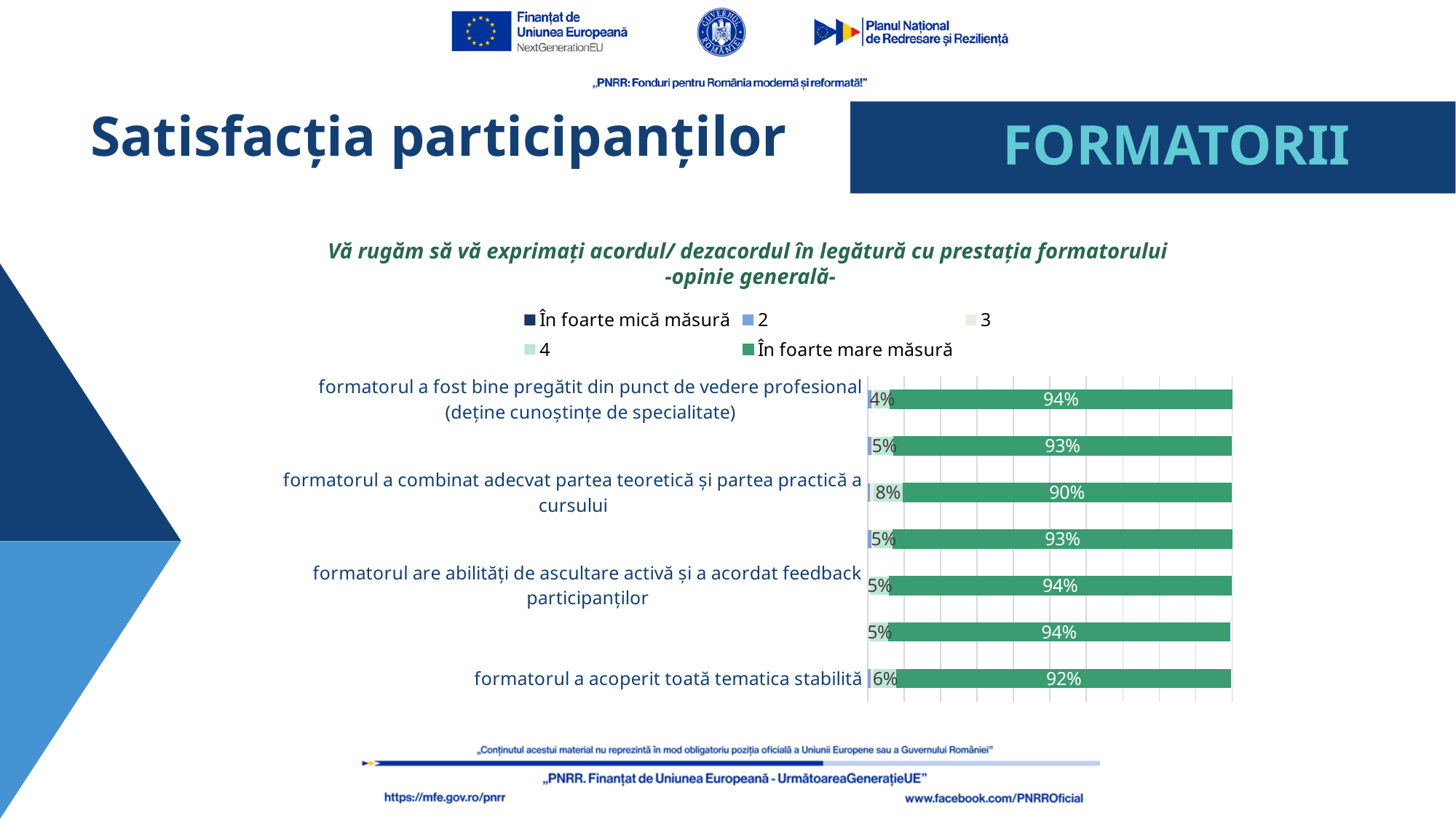
What kind of chart is shown on the slide? bar chart What is the "În foarte mare măsură" value for "formatorul a acoperit toată tematica stabilită"? 92% Which has the larger "În foarte mare măsură" value: "formatorul a acoperit toată tematica stabilită" or "formatorul a combinat adecvat partea teoretică și partea practică a cursului"? formatorul a acoperit toată tematica stabilită What is the difference between the "În foarte mare măsură" values for "formatorul a fost bine pregătit din punct de vedere profesional" and "formatorul a combinat adecvat partea teoretică și partea practică a cursului"? 4 percentage points Which labelled category has the lowest "În foarte mare măsură" value? formatorul a combinat adecvat partea teoretică și partea practică a cursului What is the "4" value for "formatorul a combinat adecvat partea teoretică și partea practică a cursului"? 8% How many series does the chart legend list? 5 What is the "În foarte mare măsură" value for "formatorul are abilități de ascultare activă și a acordat feedback participanților"? 94% How many bars are plotted in the chart? 7 What is the "4" value for "formatorul a fost bine pregătit din punct de vedere profesional (deține cunoștințe de specialitate)"? 4% What is the first entry listed in the chart legend? În foarte mică măsură What is the "În foarte mare măsură" value for "formatorul a combinat adecvat partea teoretică și partea practică a cursului"? 90%